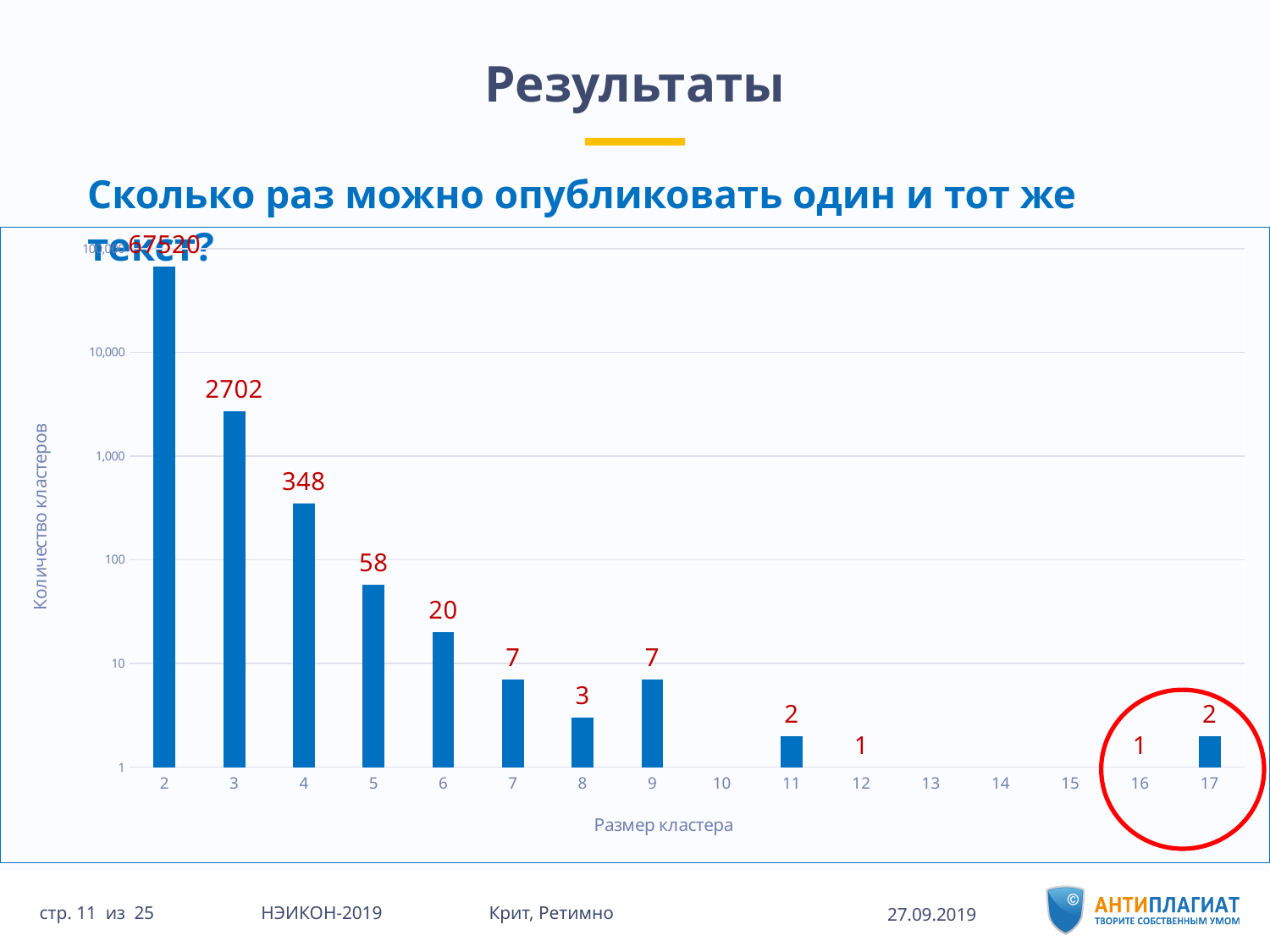
Which cluster size has the highest number of clusters? 2 Is the number of clusters for cluster size 4 greater or less than 100? greater What is the number of clusters for cluster size 5? 58 What is the label of the x axis? Размер кластера What is the number of clusters for cluster size 6? 20 What is the number of clusters for cluster size 3? 2702 What is the number of clusters for cluster size 8? 3 What is the number of clusters for cluster size 4? 348 What type of chart is shown on the slide? bar chart What is the number of clusters for cluster size 17? 2 Which has more clusters: cluster size 5 or cluster size 6? cluster size 5 What is the difference between the number of clusters for cluster size 3 and cluster size 4? 2354